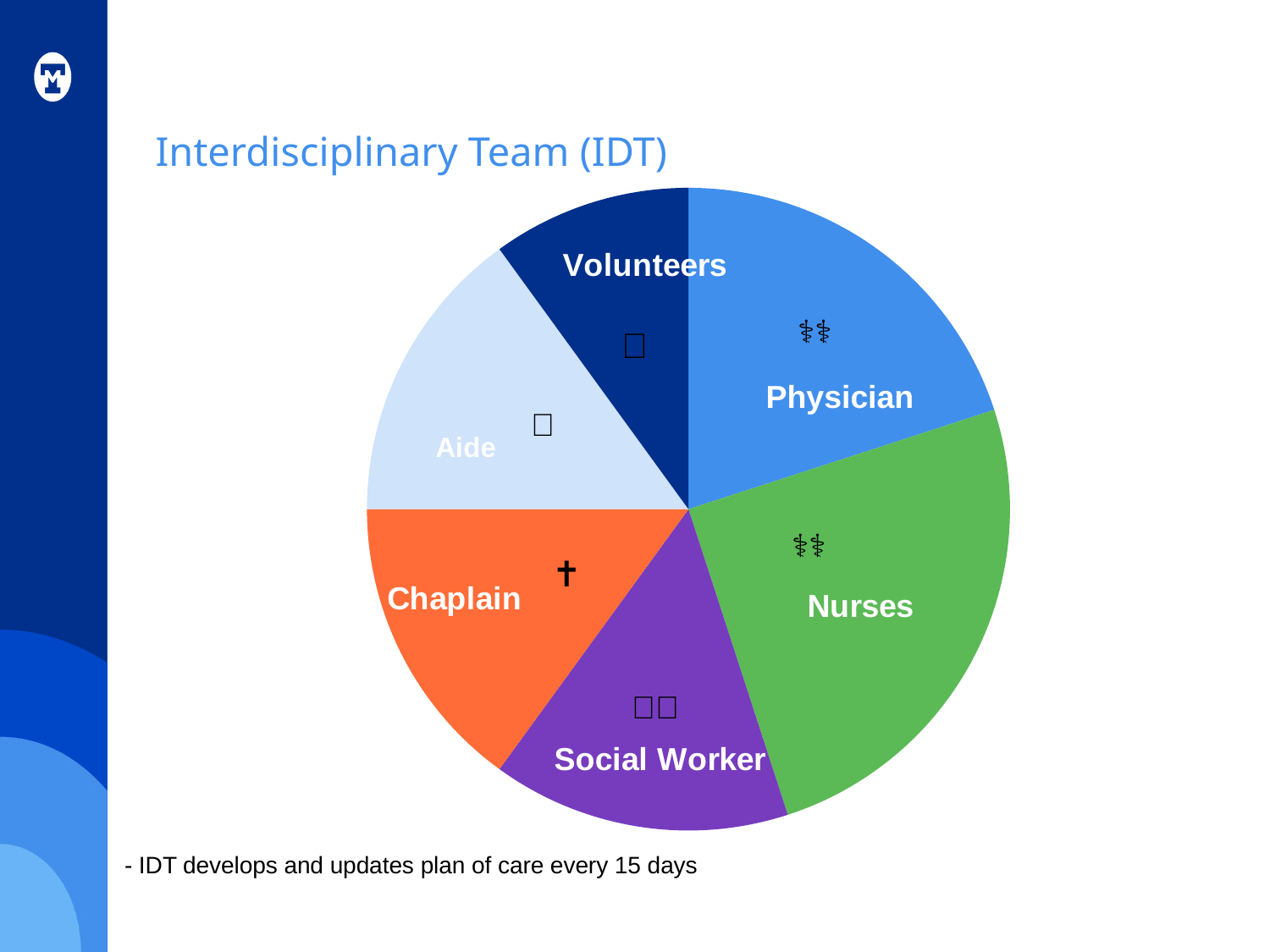
Which slice is larger, Chaplain or Volunteers? Chaplain What colour is the Nurses slice of the pie chart? Green Which slice is larger, Physician or Volunteers? Physician Which slice of the pie chart is the smallest? Volunteers Which slice is larger, Nurses or Volunteers? Nurses What kind of chart is shown on the slide? Pie chart Which slice of the pie chart is the largest? Nurses What is the title of the slide containing the pie chart? Interdisciplinary Team (IDT) How many slices does the pie chart have? 6